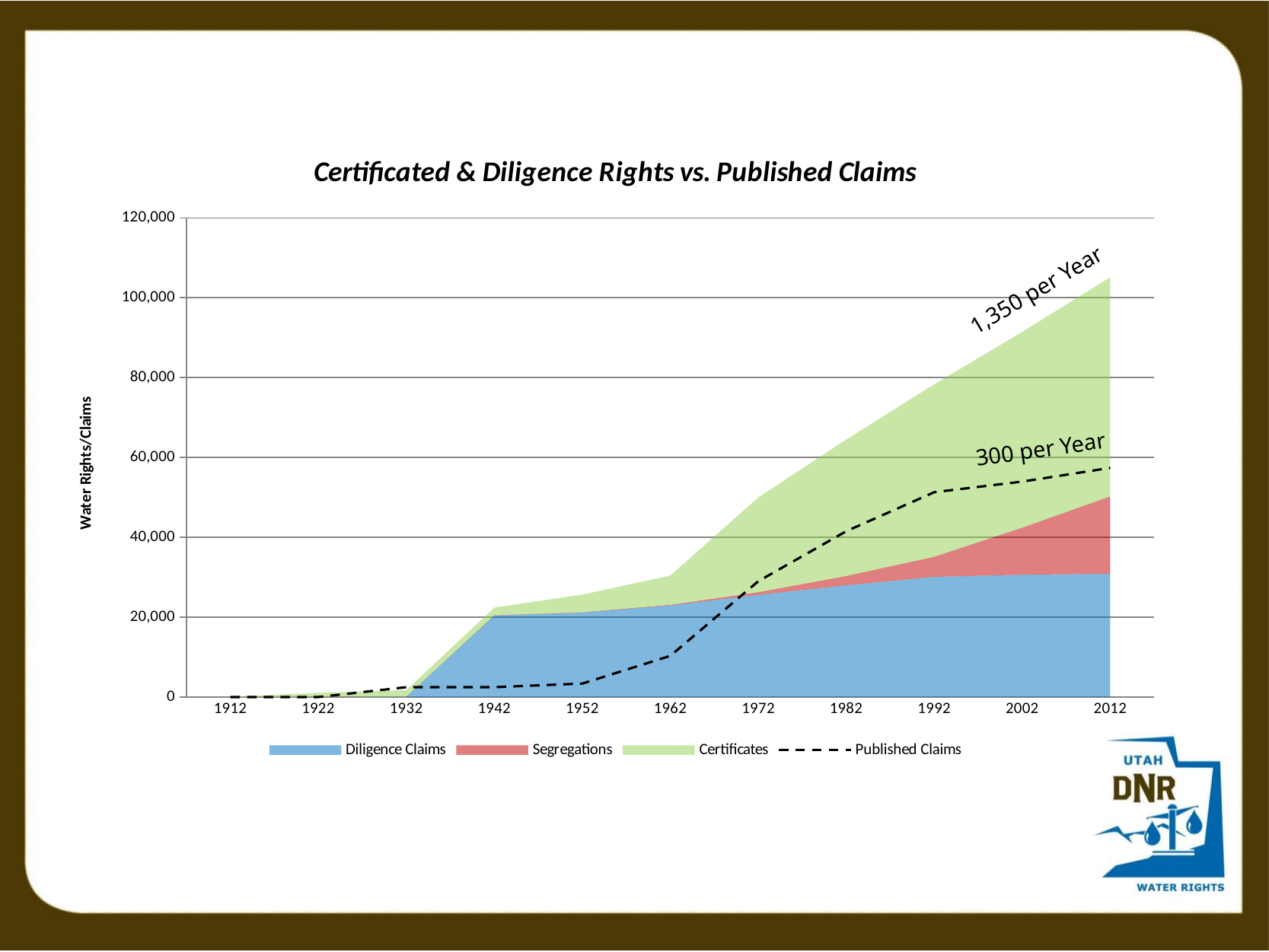
In 2012, which is larger: the total of the stacked areas or the Published Claims line? The total of the stacked areas Is the value for Published Claims in 1962 greater or less than 20,000? less Is the value for Published Claims in 2012 greater or less than 60,000? less How many series does the legend list? 4 Is the total of the stacked areas in 2012 greater or less than 100,000? greater What is the title of the chart? Certificated & Diligence Rights vs. Published Claims What is the label on the vertical axis? Water Rights/Claims Does the Published Claims line rise or fall from 1912 to 2012? rise In 1952, which is larger: Diligence Claims or Published Claims? Diligence Claims How many year labels are shown on the x axis? 11 What kind of chart is shown on the slide? Area chart (stacked area with a dashed line)